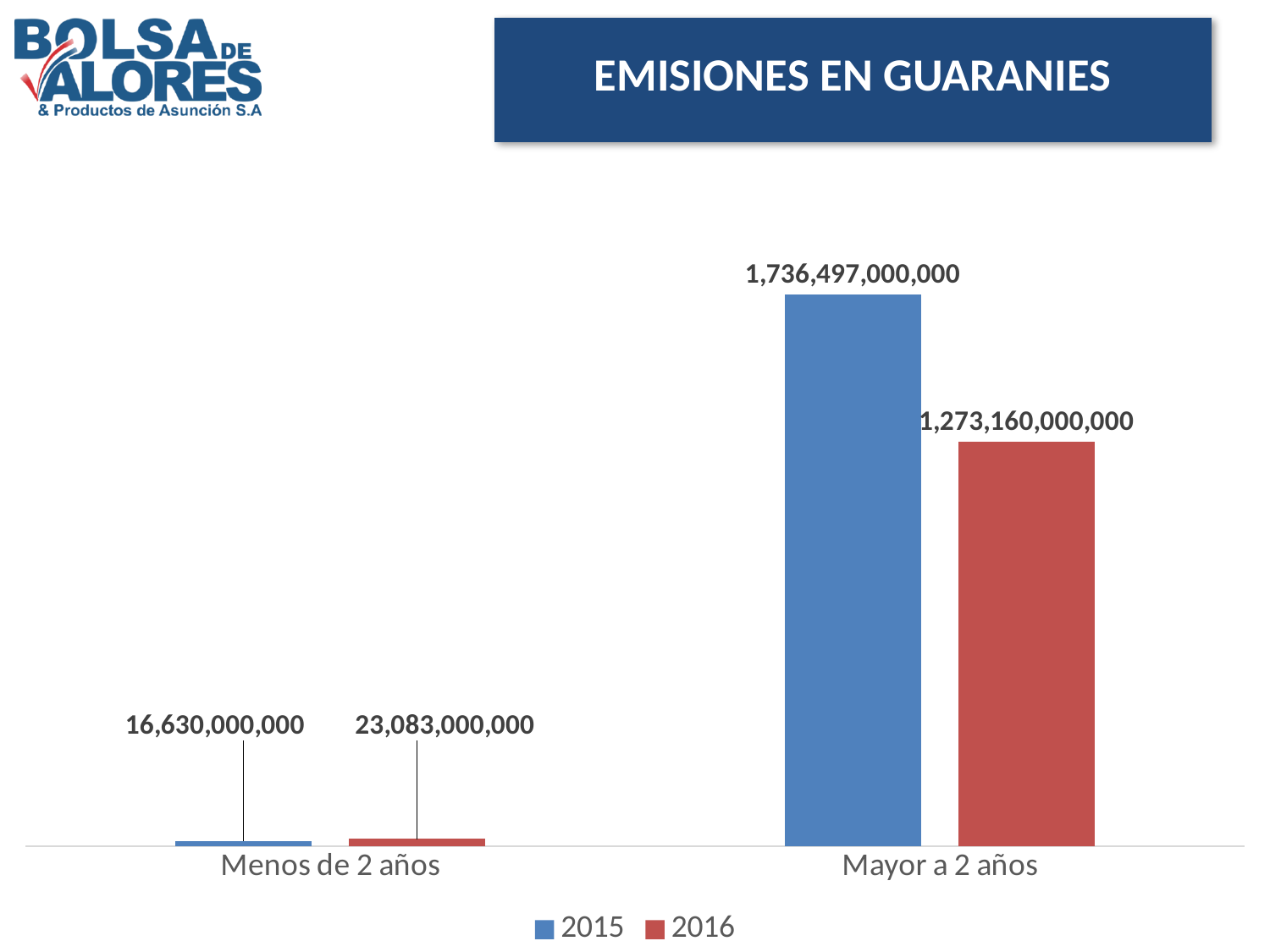
What is the value for 2016 in the 'Mayor a 2 años' category? 1,273,160,000,000 Which bar has the lowest value on the chart? 2015, Menos de 2 años Which bar has the highest value on the chart? 2015, Mayor a 2 años What is the value for 2015 in the 'Mayor a 2 años' category? 1,736,497,000,000 How many categories are shown on the x axis? 2 What type of chart is shown on the slide? Bar chart In the 'Menos de 2 años' category, which year has the larger value, 2015 or 2016? 2016 What is the difference between the 2016 and 2015 values for 'Menos de 2 años'? 6,453,000,000 How many series does the legend list? 2 What is the difference between the 2015 and 2016 values for 'Mayor a 2 años'? 463,337,000,000 What is the value for 2015 in the 'Menos de 2 años' category? 16,630,000,000 What is the value for 2016 in the 'Menos de 2 años' category? 23,083,000,000